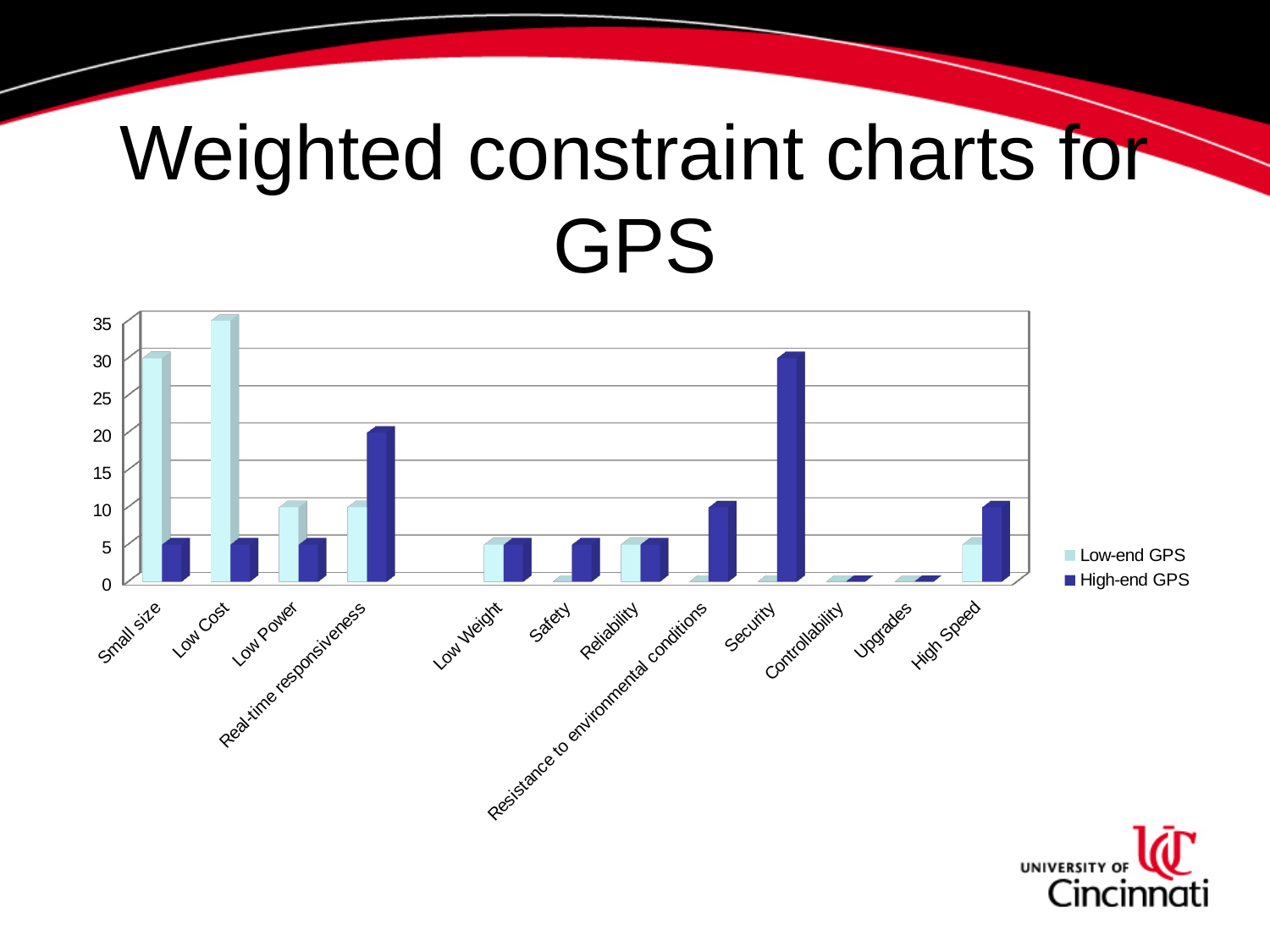
What kind of chart is shown on the slide? Bar chart What is the High-end GPS value for Security? 30 For Real-time responsiveness, which is larger: the Low-end GPS value or the High-end GPS value? High-end GPS Which series is shown in dark blue in the legend? High-end GPS Is the High-end GPS value for Security greater or less than 25? greater Which category has the highest Low-end GPS value? Low Cost What is the High-end GPS value for Real-time responsiveness? 20 What is the Low-end GPS value for Low Cost? 35 How many categories are shown on the x axis? 12 How many series does the legend list? 2 Which category has the highest High-end GPS value? Security What is the difference between the Low-end GPS and High-end GPS values for Low Cost? 30